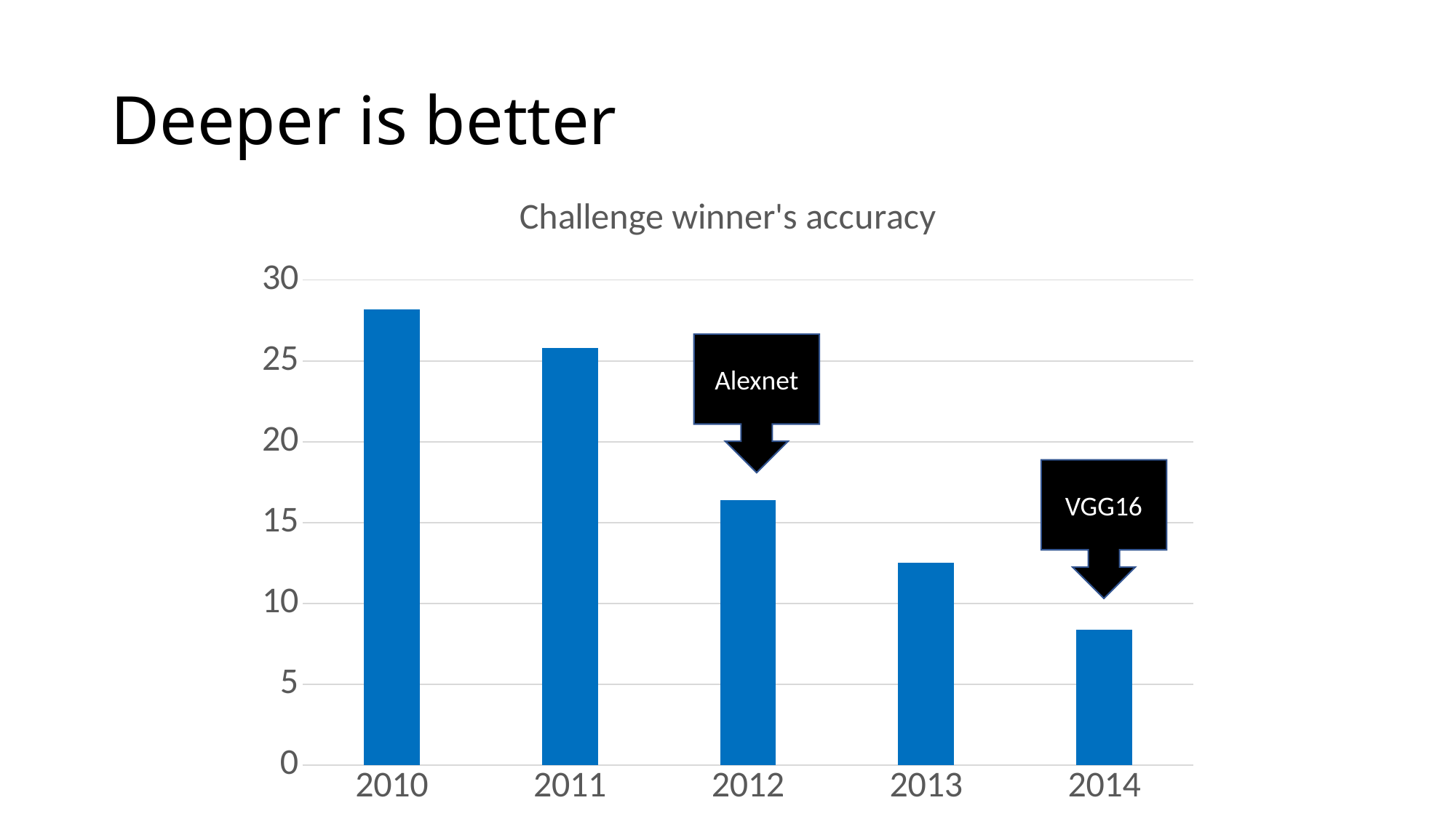
Is the value for 2013 greater or less than 10? greater How many years are shown on the x axis of the chart? 5 Is the value for 2014 greater or less than 10? less What is the title of the chart? Challenge winner's accuracy Which year's bar is labelled with the annotation "Alexnet"? 2012 Which is larger, the value for 2011 or the value for 2012? 2011 Which year has the highest bar in the chart? 2010 Do the values rise or fall from 2010 to 2014? fall Is the value for 2012 greater or less than 20? less What kind of chart is shown on the slide? bar chart Which year has the lowest bar in the chart? 2014